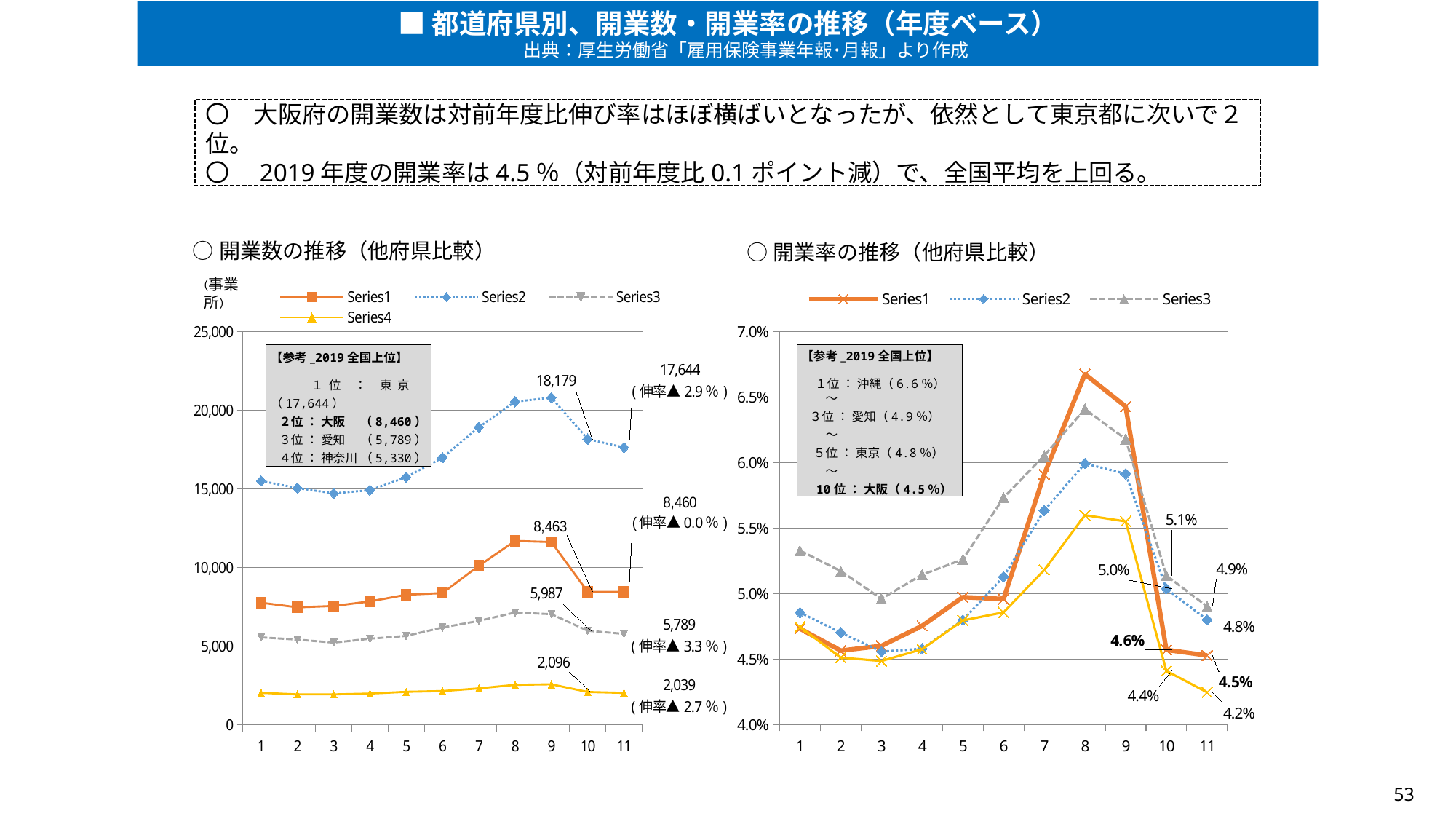
In the left chart (開業数の推移), which series has the highest value at point 11? Series2 In the left chart (開業数の推移), what is the difference between Series2 and Series1 at point 11? 9,184 In the right chart (開業率の推移), which is larger at point 11: Series1 or Series2? Series2 In the right chart (開業率の推移), how many series does the legend list? 3 In the left chart (開業数の推移), how many points are plotted along the x axis for each series? 11 In the right chart (開業率の推移), is the value of Series1 at point 8 greater or less than 6.5%? greater In the right chart (開業率の推移), what is the value of Series1 at point 11? 4.5% In the left chart (開業数の推移), what is the value of Series2 at point 11? 17,644 What kind of chart is the left chart titled 開業数の推移（他府県比較）? line chart In the left chart (開業数の推移), how many series does the legend list? 4